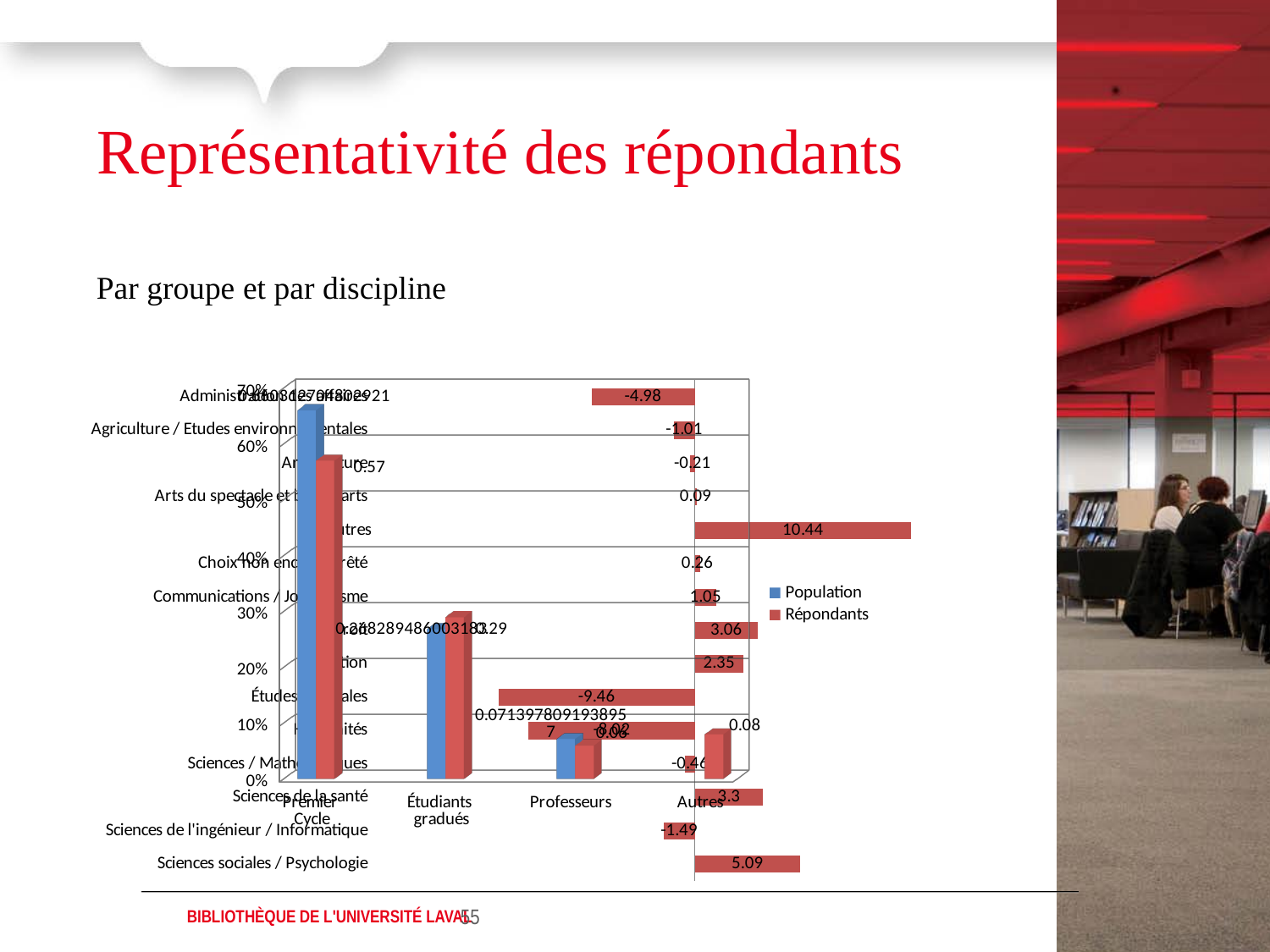
In the chart by group, is the Population value for Professeurs greater or less than 10%? less In the chart by discipline, what is the value for Sciences sociales / Psychologie? 5.09 In the chart by group, what is the Répondants value for Étudiants gradués? 0.29 In the chart by group (Premier Cycle, Étudiants gradués, Professeurs, Autres), how many series does the legend list? 2 In the chart by group, which group has the highest Population value? Premier Cycle What kind of chart is the chart by group? bar chart In the chart by group, what is the Répondants value for Premier Cycle? 0.57 In the chart by group, how many groups are shown on the x axis? 4 In the chart by group, what are the two legend entries? Population and Répondants In the chart by discipline, what is the value for Sciences de l'ingénieur / Informatique? -1.49 In the chart by discipline, which is larger: the value for Sciences de la santé or the value for Communications / Journalisme? Sciences de la santé In the chart by discipline, what is the value for Agriculture / Etudes environnementales? -1.01